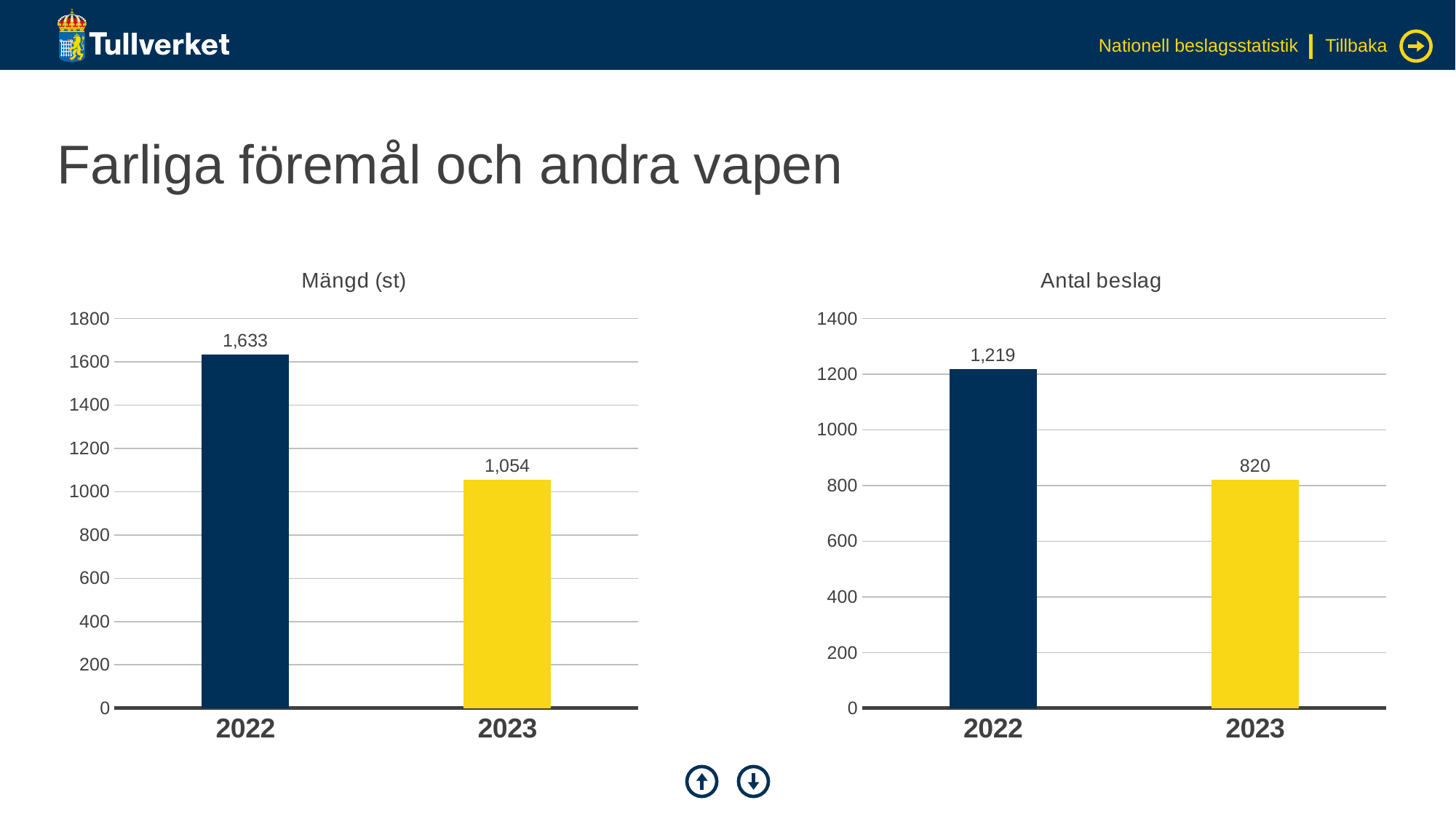
What kind of chart is the 'Antal beslag' chart? Bar chart In the 'Mängd (st)' chart, what is the value for 2023? 1,054 In the 'Mängd (st)' chart, how many bars are plotted? 2 In the 'Mängd (st)' chart, what is the difference between the 2022 and 2023 values? 579 In the 'Mängd (st)' chart, which year has the highest value? 2022 In the 'Antal beslag' chart, is the value for 2022 greater or less than 1000? greater In the 'Antal beslag' chart, what is the value for 2023? 820 In the 'Antal beslag' chart, which year has the lowest value? 2023 In the 'Antal beslag' chart, what is the difference between the 2022 and 2023 values? 399 In the 'Mängd (st)' chart, what is the value for 2022? 1,633 In the 'Mängd (st)' chart, do the values rise or fall from 2022 to 2023? Fall In the 'Antal beslag' chart, what is the value for 2022? 1,219